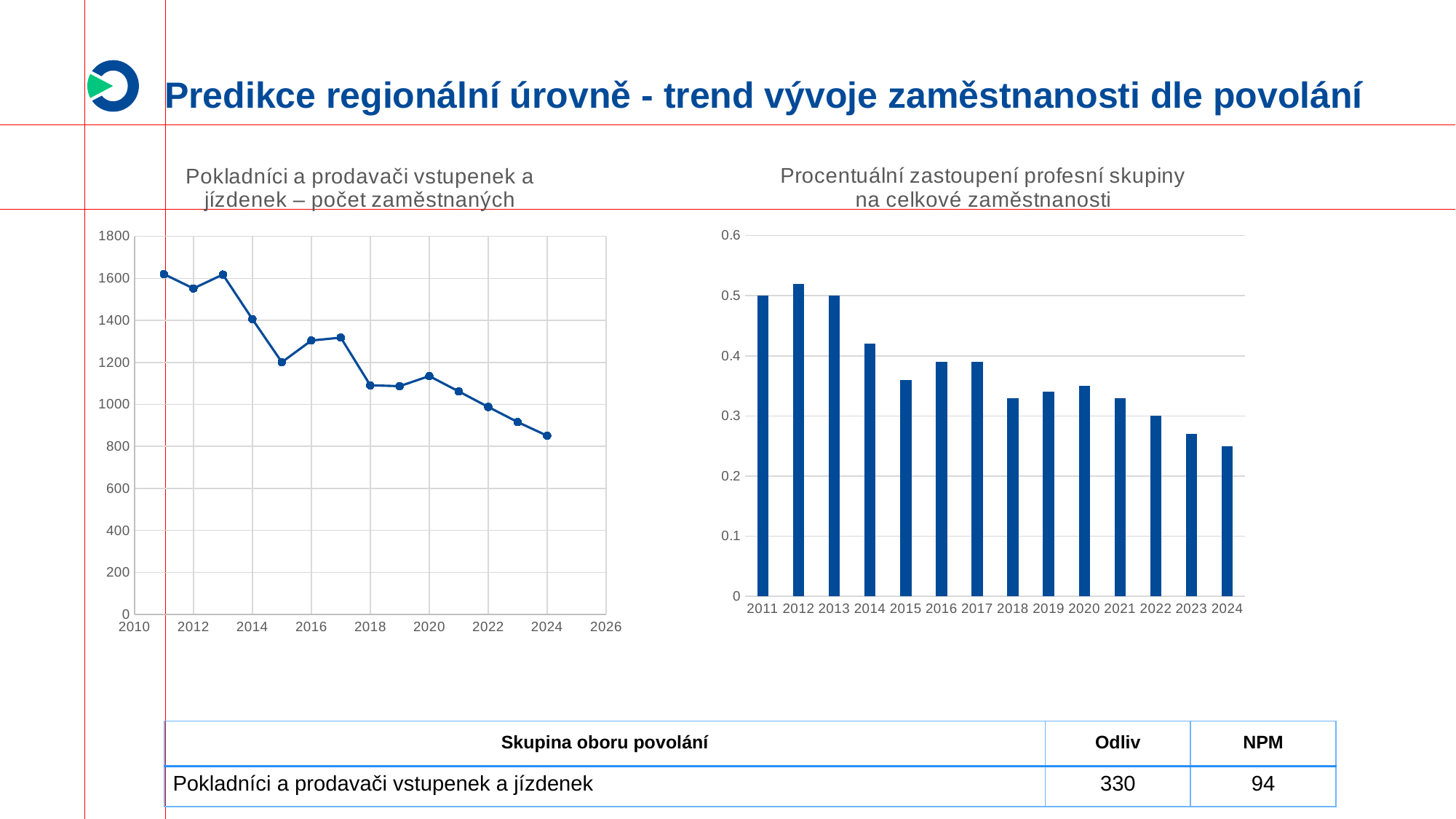
How many bars are shown in the chart "Procentuální zastoupení profesní skupiny na celkové zaměstnanosti"? 14 In the chart "Pokladníci a prodavači vstupenek a jízdenek – počet zaměstnaných", which year has the lowest value? 2024 In the chart "Pokladníci a prodavači vstupenek a jízdenek – počet zaměstnaných", do the values generally rise or fall from 2011 to 2024? fall In the chart "Procentuální zastoupení profesní skupiny na celkové zaměstnanosti", which is larger, the value for 2014 or the value for 2018? 2014 In the chart "Procentuální zastoupení profesní skupiny na celkové zaměstnanosti", which year has the lowest bar? 2024 In the chart "Pokladníci a prodavači vstupenek a jízdenek – počet zaměstnaných", is the value for 2014 greater or less than 1200? greater In the chart "Pokladníci a prodavači vstupenek a jízdenek – počet zaměstnaných", is the value for 2024 greater or less than 1000? less In the chart "Procentuální zastoupení profesní skupiny na celkové zaměstnanosti", which year has the highest bar? 2012 What kind of chart is the chart titled "Procentuální zastoupení profesní skupiny na celkové zaměstnanosti"? bar chart What kind of chart is the chart titled "Pokladníci a prodavači vstupenek a jízdenek – počet zaměstnaných"? line chart How many data points are plotted in the chart "Pokladníci a prodavači vstupenek a jízdenek – počet zaměstnaných"? 14 In the chart "Procentuální zastoupení profesní skupiny na celkové zaměstnanosti", is the value for 2024 greater or less than 0.3? less